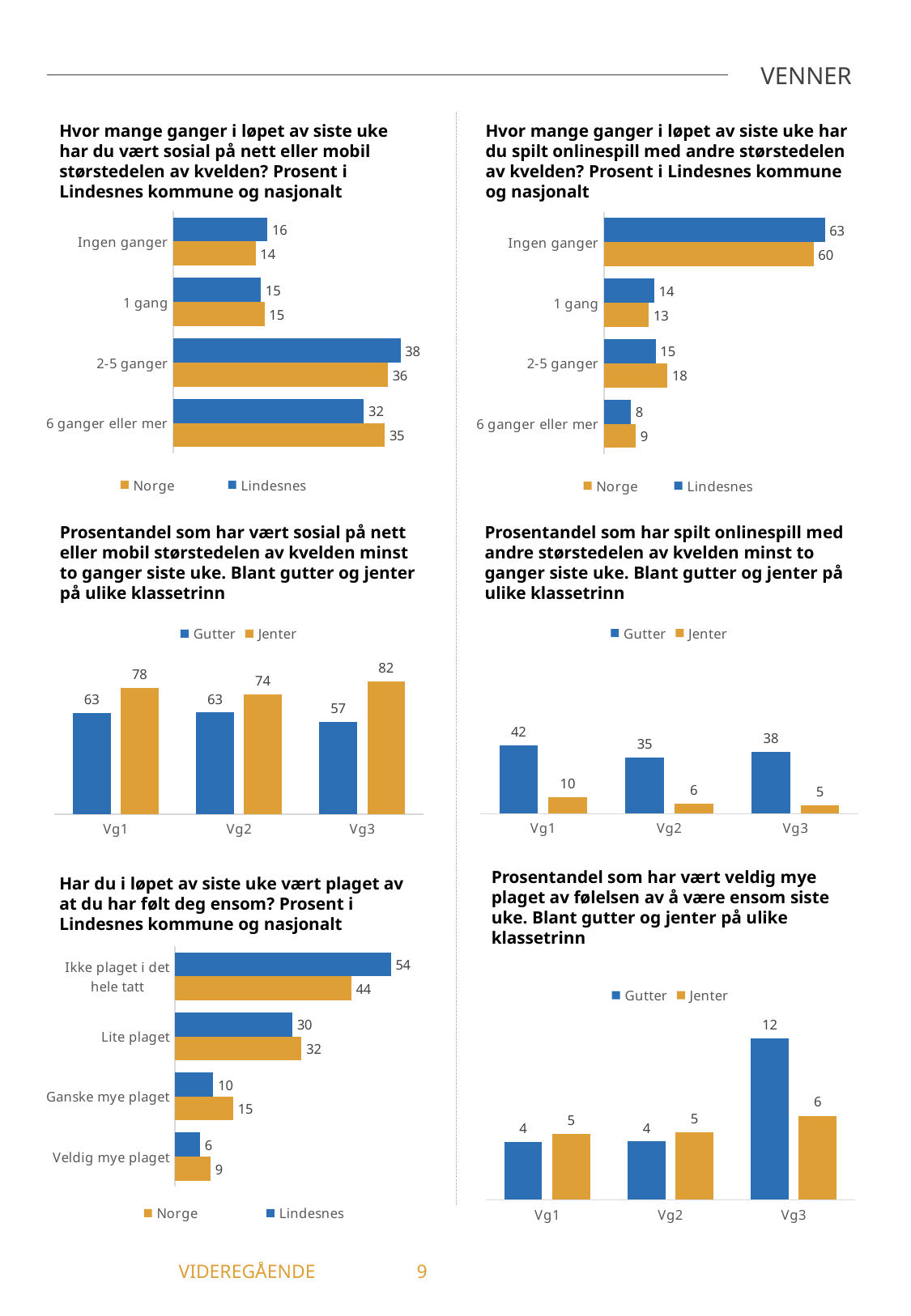
In the middle-left chart (sosial på nett minst to ganger, gutter og jenter), which is larger for Vg1: Gutter or Jenter? Jenter In the bottom-left chart (plaget av å ha følt deg ensom), what is the Lindesnes value for 'Ikke plaget i det hele tatt'? 54 In the middle-right chart (spilt onlinespill minst to ganger, gutter og jenter), what is the difference between Gutter and Jenter for Vg1? 32 In the middle-left chart (sosial på nett minst to ganger, gutter og jenter), what is the Jenter value for Vg3? 82 In the top-right chart (spilt onlinespill), what is the Norge value for '2-5 ganger'? 18 In the top-right chart (spilt onlinespill), how many categories are shown? 4 In the top-left chart (sosial på nett eller mobil), what is the Lindesnes value for '2-5 ganger'? 38 In the bottom-right chart (veldig mye plaget av ensomhet, gutter og jenter), what is the Gutter value for Vg3? 12 What type of chart is the bottom-left chart (plaget av å ha følt deg ensom)? Bar chart In the middle-right chart (spilt onlinespill minst to ganger, gutter og jenter), which class level has the lowest Jenter value? Vg3 In the top-right chart (spilt onlinespill), which category has the highest Lindesnes value? Ingen ganger In the top-left chart (sosial på nett eller mobil), what is the difference between the Norge and Lindesnes values for '6 ganger eller mer'? 3